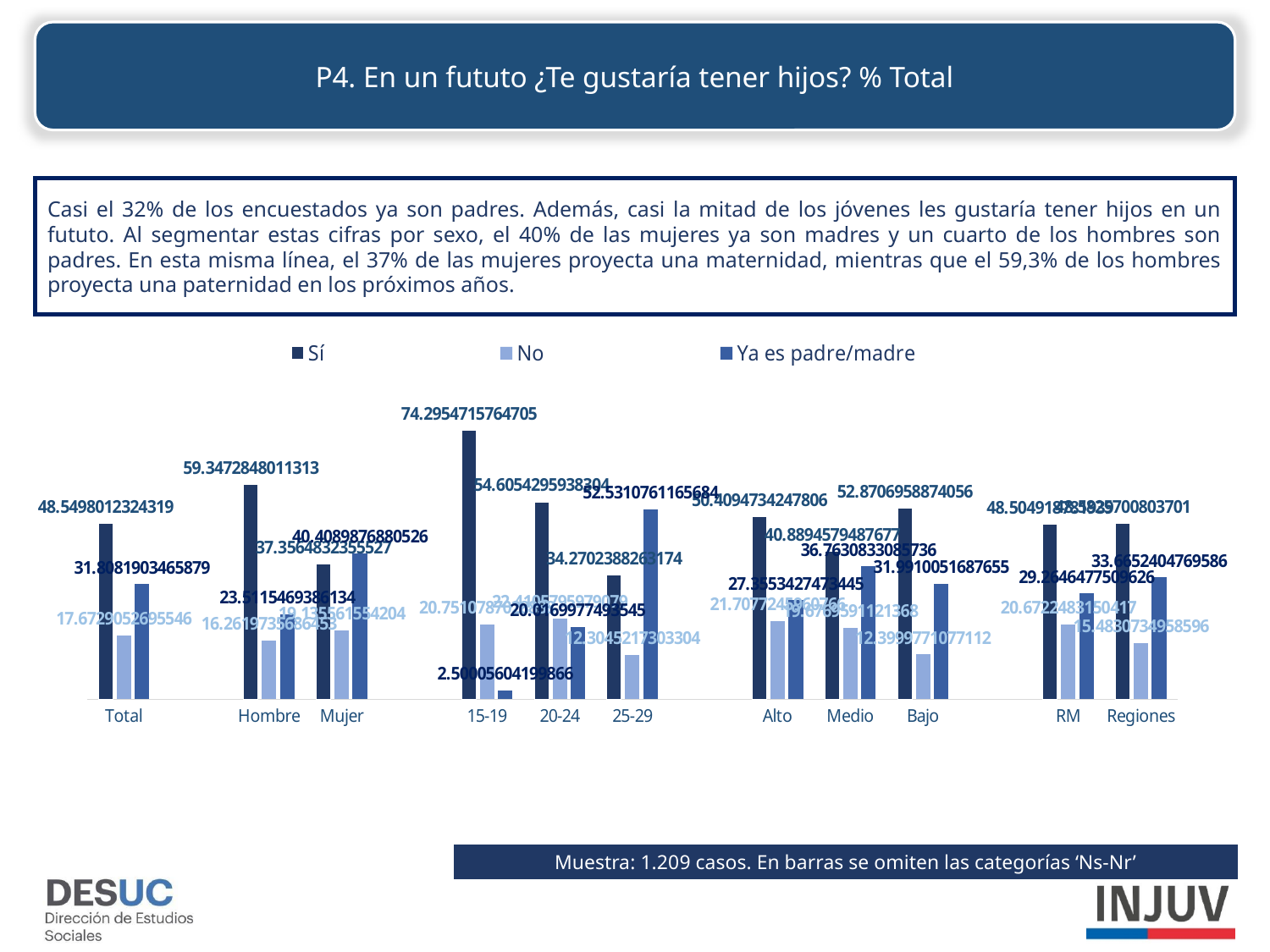
What is the value of 'Sí' for the 15-19 category? 74.2954715764705 How many categories are shown along the x axis? 11 Across the age groups 15-19, 20-24 and 25-29, does the 'Sí' value rise or fall? Fall What is the value of 'Sí' for Hombre? 59.3472848011313 Which category has the lowest 'Ya es padre/madre' value? 15-19 What is the value of 'No' for Bajo? 12.3999771077112 What is the value of 'Ya es padre/madre' for the 25-29 category? 52.5310761165684 For Mujer, which is larger: 'Sí' or 'Ya es padre/madre'? Ya es padre/madre What kind of chart is shown on the slide? Bar chart What is the difference between the 'Sí' value for Hombre and the 'Sí' value for Mujer? 21.9908015655786 Which category has the highest 'Sí' value? 15-19 How many series does the legend list? 3